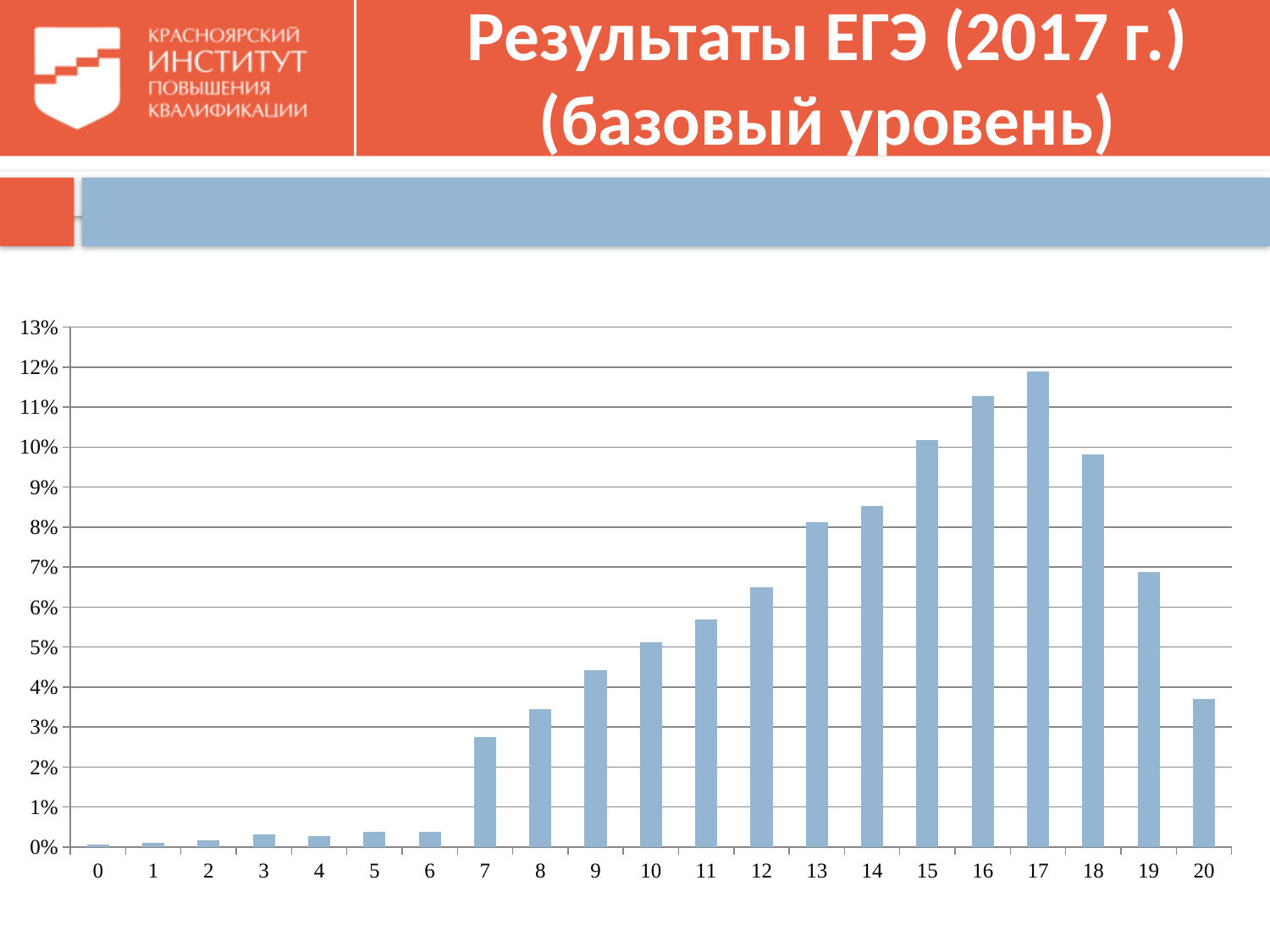
Is the value for category 15 greater or less than 10%? greater Is the value for category 20 greater or less than 3%? greater Is the value for category 7 greater or less than 3%? less Which has the larger value, category 13 or category 19? 13 Which category has the lowest bar in the chart? 0 What kind of chart is shown on the slide? bar chart Which category has the highest bar in the chart? 17 Which has the larger value, category 16 or category 18? 16 How many categories are shown on the x axis of the chart? 21 What is the title of the slide containing the chart? Результаты ЕГЭ (2017 г.) (базовый уровень)